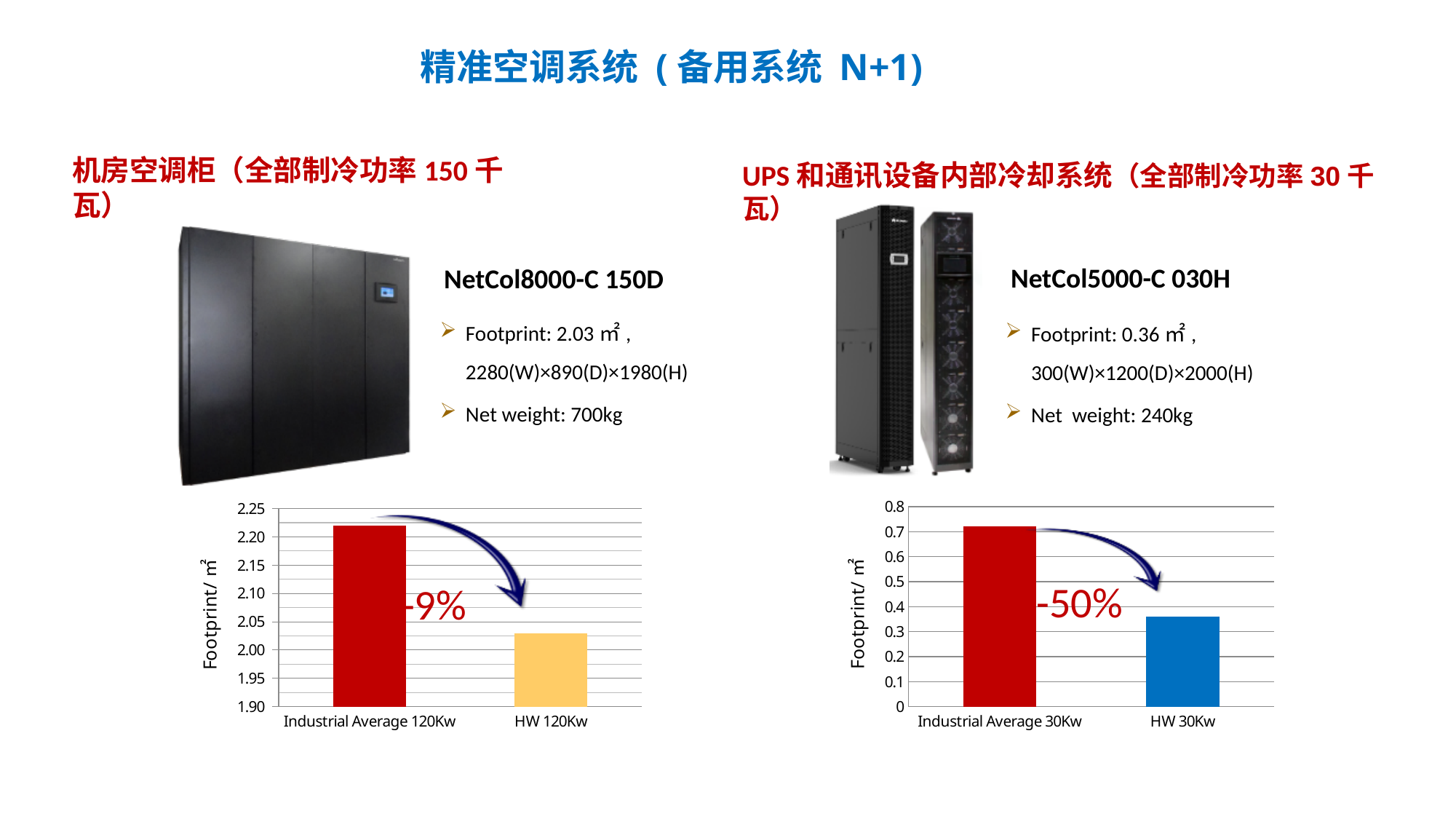
What percentage reduction is annotated on the left chart (Industrial Average 120Kw vs HW 120Kw)? -9% On the right chart, is the value for Industrial Average 30Kw greater or less than 0.5? greater On the right chart (Industrial Average 30Kw vs HW 30Kw), which category has the lowest footprint? HW 30Kw On the right chart, is the value for HW 30Kw greater or less than 0.4? less On the right chart, which is larger: Industrial Average 30Kw or HW 30Kw? Industrial Average 30Kw What kind of chart is the left chart (Industrial Average 120Kw vs HW 120Kw)? bar chart On the left chart, is the value for HW 120Kw greater or less than 2.10? less On the left chart (Industrial Average 120Kw vs HW 120Kw), which category has the highest footprint? Industrial Average 120Kw How many categories are shown on the right chart (Industrial Average 30Kw vs HW 30Kw)? 2 How many categories are shown on the left chart (Industrial Average 120Kw vs HW 120Kw)? 2 What is the y-axis label on the right chart (Industrial Average 30Kw vs HW 30Kw)? Footprint/ m²